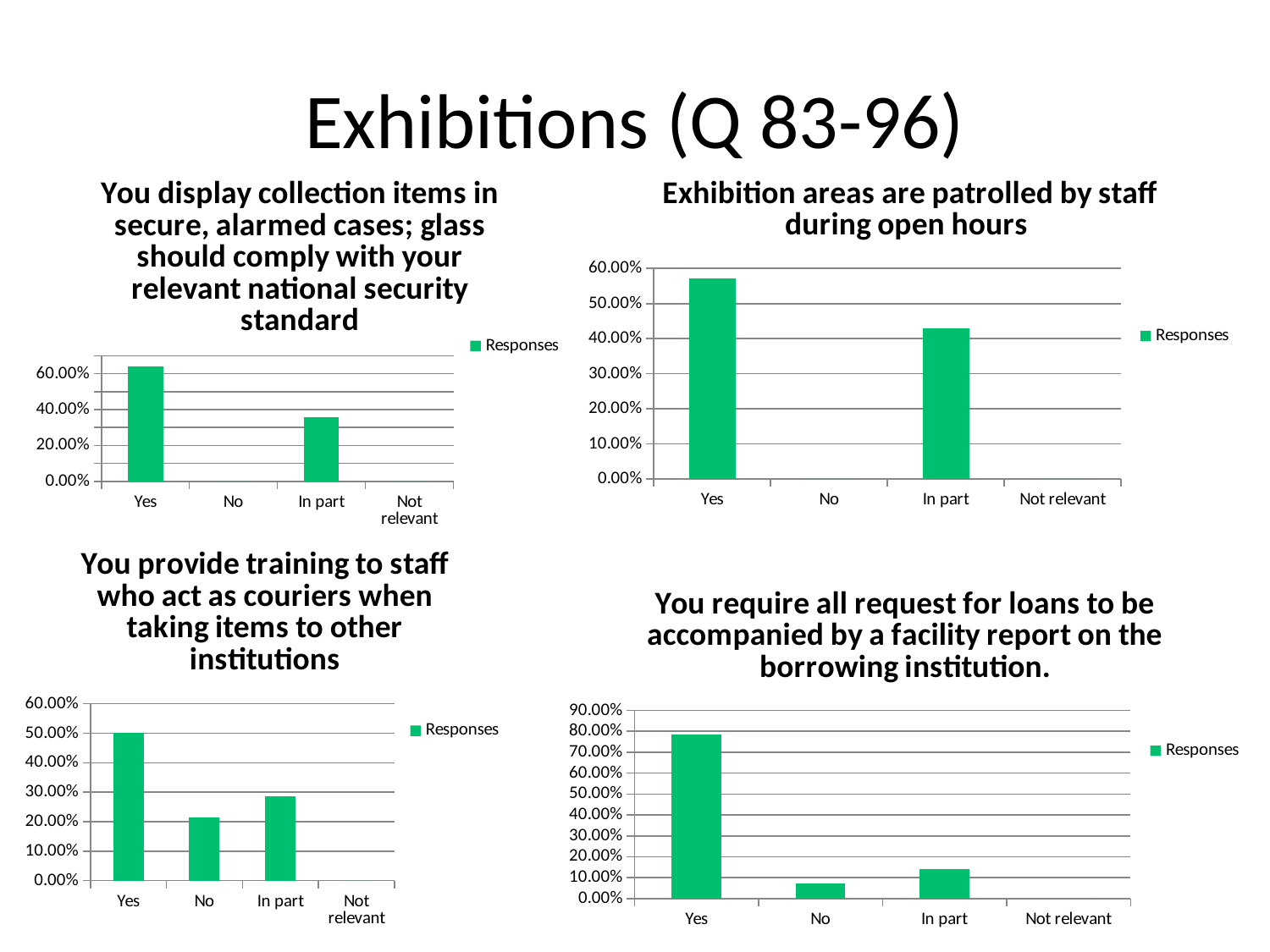
In the chart titled 'You require all request for loans to be accompanied by a facility report on the borrowing institution.', is the value for No greater or less than 10.00%? less In the chart titled 'Exhibition areas are patrolled by staff during open hours', is the value for Yes greater or less than 50.00%? greater In the chart titled 'You require all request for loans to be accompanied by a facility report on the borrowing institution.', is the value for Yes greater or less than 70.00%? greater In the chart titled 'You require all request for loans to be accompanied by a facility report on the borrowing institution.', which of No or In part has the larger value? In part What type of chart is the chart titled 'You provide training to staff who act as couriers when taking items to other institutions'? bar chart In the chart titled 'You provide training to staff who act as couriers when taking items to other institutions', which of No or In part has the larger value? In part In the chart titled 'Exhibition areas are patrolled by staff during open hours', which category has the highest value? Yes How many categories are shown on the x axis of the chart titled 'Exhibition areas are patrolled by staff during open hours'? 4 In the top-left chart about displaying collection items in secure, alarmed cases, which of Yes or In part has the larger value? Yes